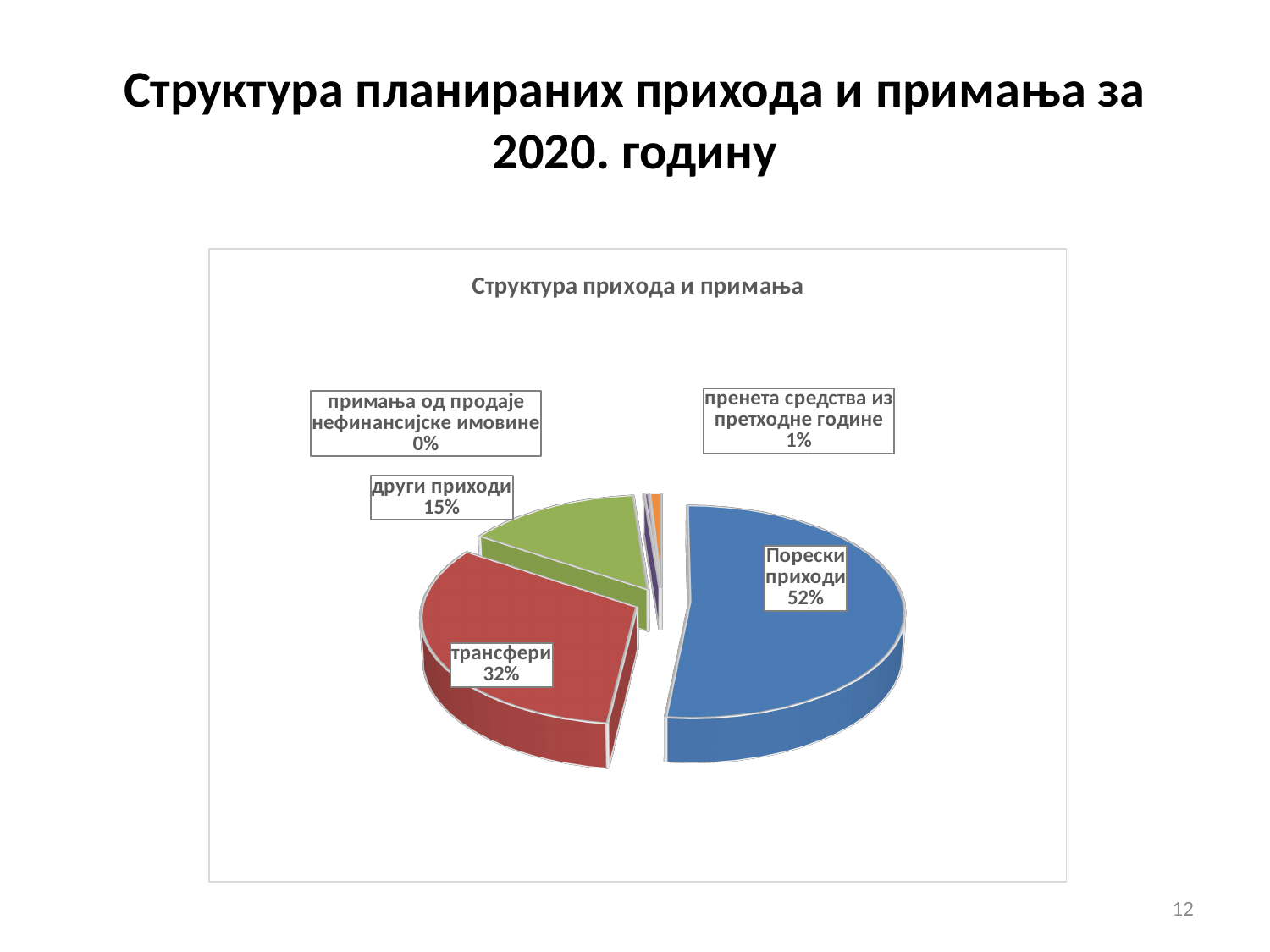
How many categories are shown in the pie chart? 5 What share of the pie does примања од продаје нефинансијске имовине have? 0% Which category has the largest share of the pie? Порески приходи What share of the pie does други приходи have? 15% What kind of chart is shown on the slide? Pie chart What share of the pie does пренета средства из претходне године have? 1% Which category has the smallest share of the pie? примања од продаје нефинансијске имовине What is the title of the chart? Структура прихода и примања Which is larger, трансфери or други приходи? трансфери What is the difference in percentage points between Порески приходи and трансфери? 20